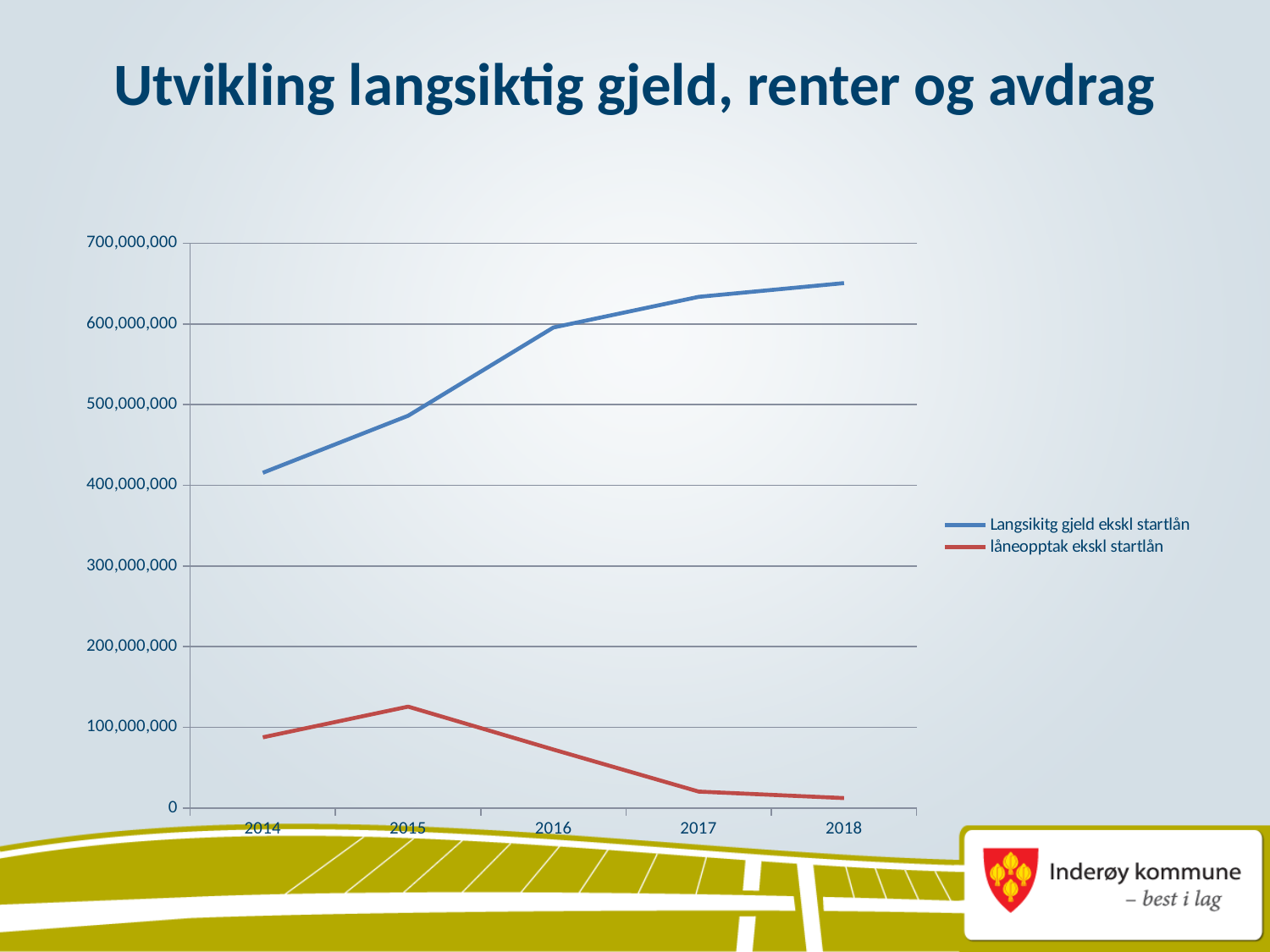
How many years are shown on the x axis? 5 Does the value for Langsikitg gjeld ekskl startlån rise or fall from 2014 to 2018? rise Is the value for låneopptak ekskl startlån in 2015 greater or less than 100,000,000? greater Which series is drawn in red? låneopptak ekskl startlån Is the value for Langsikitg gjeld ekskl startlån in 2014 greater or less than 400,000,000? greater How many series does the legend list? 2 In which year is the value for Langsikitg gjeld ekskl startlån highest? 2018 What is the title of the chart? Utvikling langsiktig gjeld, renter og avdrag What kind of chart is shown on the slide? Line chart In which year is the value for låneopptak ekskl startlån highest? 2015 Is the value for Langsikitg gjeld ekskl startlån in 2018 greater or less than 600,000,000? greater In which year is the value for Langsikitg gjeld ekskl startlån lowest? 2014